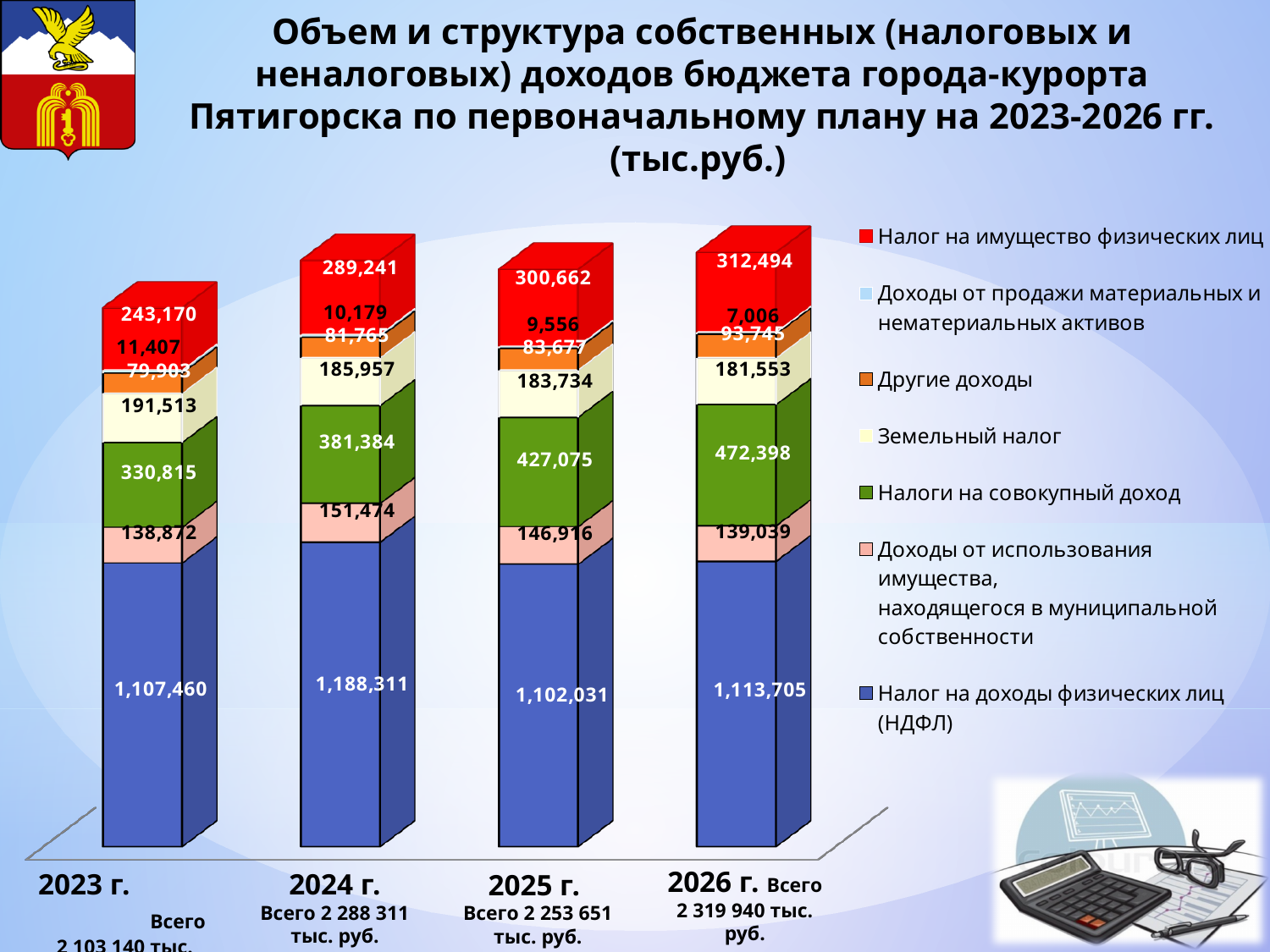
What is the total (Всего) of the stacked bar for 2024 г.? 2 288 311 тыс. руб. What type of chart is shown on the slide? Stacked bar chart How many series does the chart legend list? 7 In which year is Доходы от продажи материальных и нематериальных активов the lowest? 2026 г. In which year is Налог на имущество физических лиц the highest? 2026 г. What is the value of Налог на доходы физических лиц (НДФЛ) for 2024 г.? 1,188,311 What is the difference between Налог на имущество физических лиц in 2026 г. and in 2023 г.? 69,324 How many years (categories) are shown on the x axis of the chart? 4 Which is larger: Налоги на совокупный доход in 2025 г. or in 2024 г.? 2025 г. What is the value of Земельный налог for 2023 г.? 191,513 What is the value of Налоги на совокупный доход for 2026 г.? 472,398 Do the values of Налоги на совокупный доход rise or fall from 2023 г. to 2026 г.? Rise